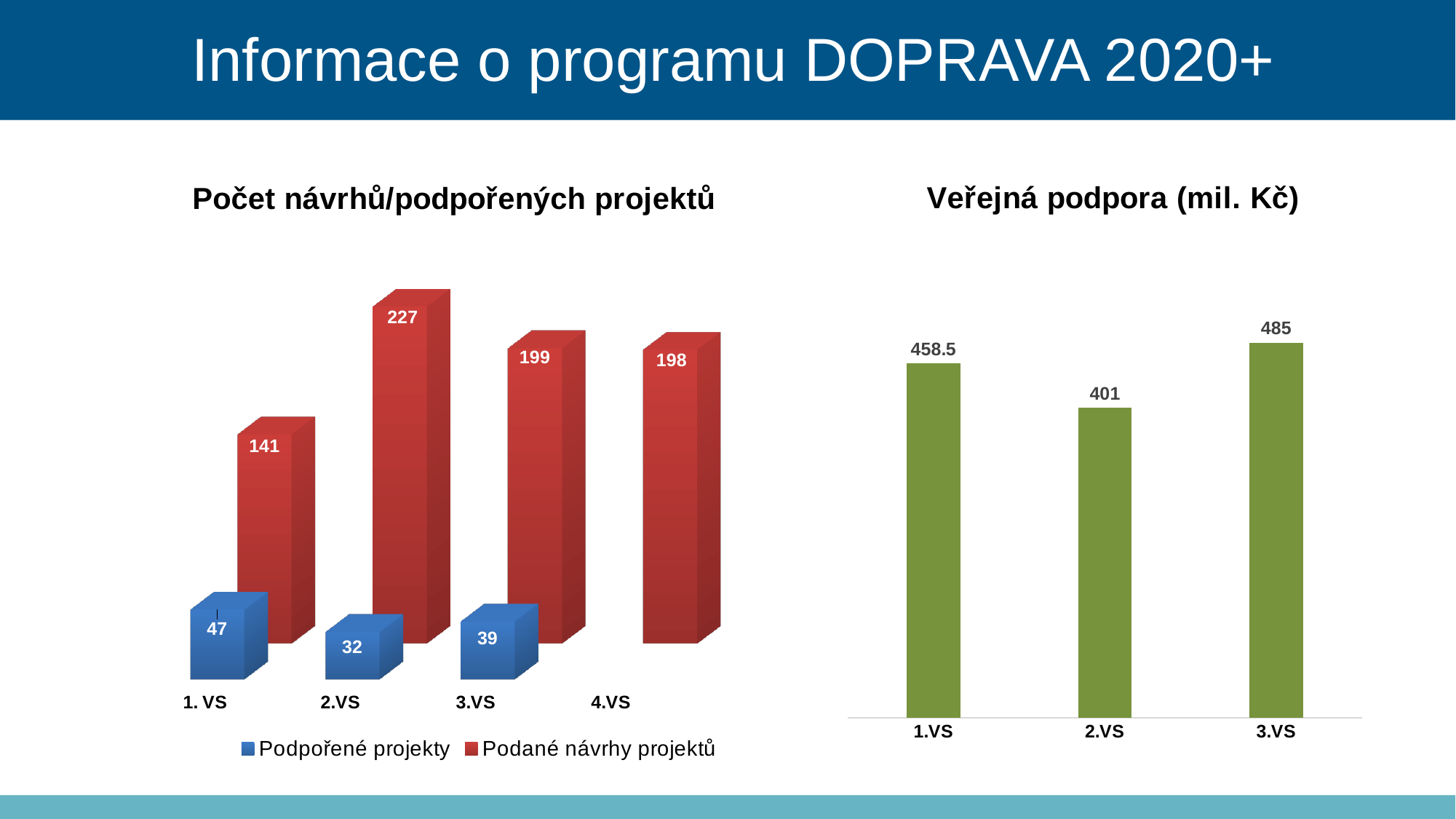
In the chart 'Počet návrhů/podpořených projektů', how many categories are shown on the x axis? 4 In the chart 'Veřejná podpora (mil. Kč)', what is the difference between the values for 3.VS and 1.VS? 26.5 In the chart 'Veřejná podpora (mil. Kč)', what is the value for 2.VS? 401 What kind of chart is 'Veřejná podpora (mil. Kč)'? bar chart In the chart 'Počet návrhů/podpořených projektů', how many series does the legend list? 2 In the chart 'Veřejná podpora (mil. Kč)', which category has the highest value? 3.VS In the chart 'Počet návrhů/podpořených projektů', which category has the lowest value for 'Podpořené projekty'? 2.VS In the chart 'Počet návrhů/podpořených projektů', what is the value of 'Podané návrhy projektů' for 2.VS? 227 In the chart 'Veřejná podpora (mil. Kč)', which is larger, the value for 1.VS or the value for 2.VS? 1.VS In the chart 'Počet návrhů/podpořených projektů', which category has the highest value for 'Podané návrhy projektů'? 2.VS In the chart 'Počet návrhů/podpořených projektů', what is the difference between 'Podané návrhy projektů' and 'Podpořené projekty' for 3.VS? 160 In the chart 'Počet návrhů/podpořených projektů', what is the value of 'Podpořené projekty' for 1. VS? 47